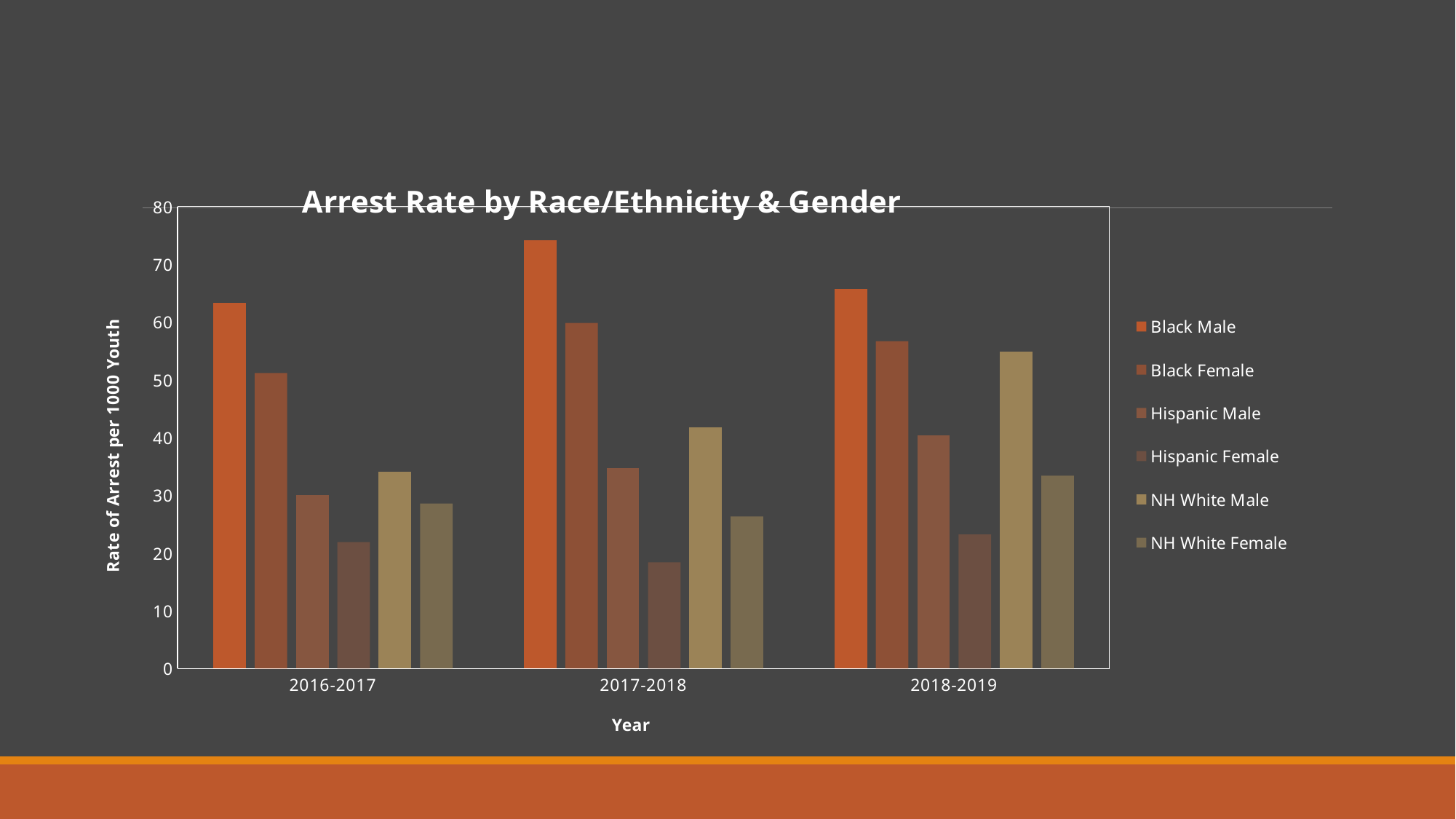
Which series has the lowest bar in 2017-2018? Hispanic Female How many series does the legend list? 6 Does the NH White Male arrest rate rise or fall from 2016-2017 to 2018-2019? rise Is the value for NH White Male in 2018-2019 greater or less than 50? greater Is the value for Black Male in 2017-2018 greater or less than 70? greater In 2016-2017, which is larger: the NH White Female rate or the Hispanic Female rate? NH White Female How many year categories are shown on the x axis? 3 Is the value for Hispanic Female in 2017-2018 greater or less than 20? less In which year is the Black Male arrest rate highest? 2017-2018 What is the label on the vertical axis? Rate of Arrest per 1000 Youth What is the title of the chart? Arrest Rate by Race/Ethnicity & Gender What kind of chart is shown on the slide? bar chart